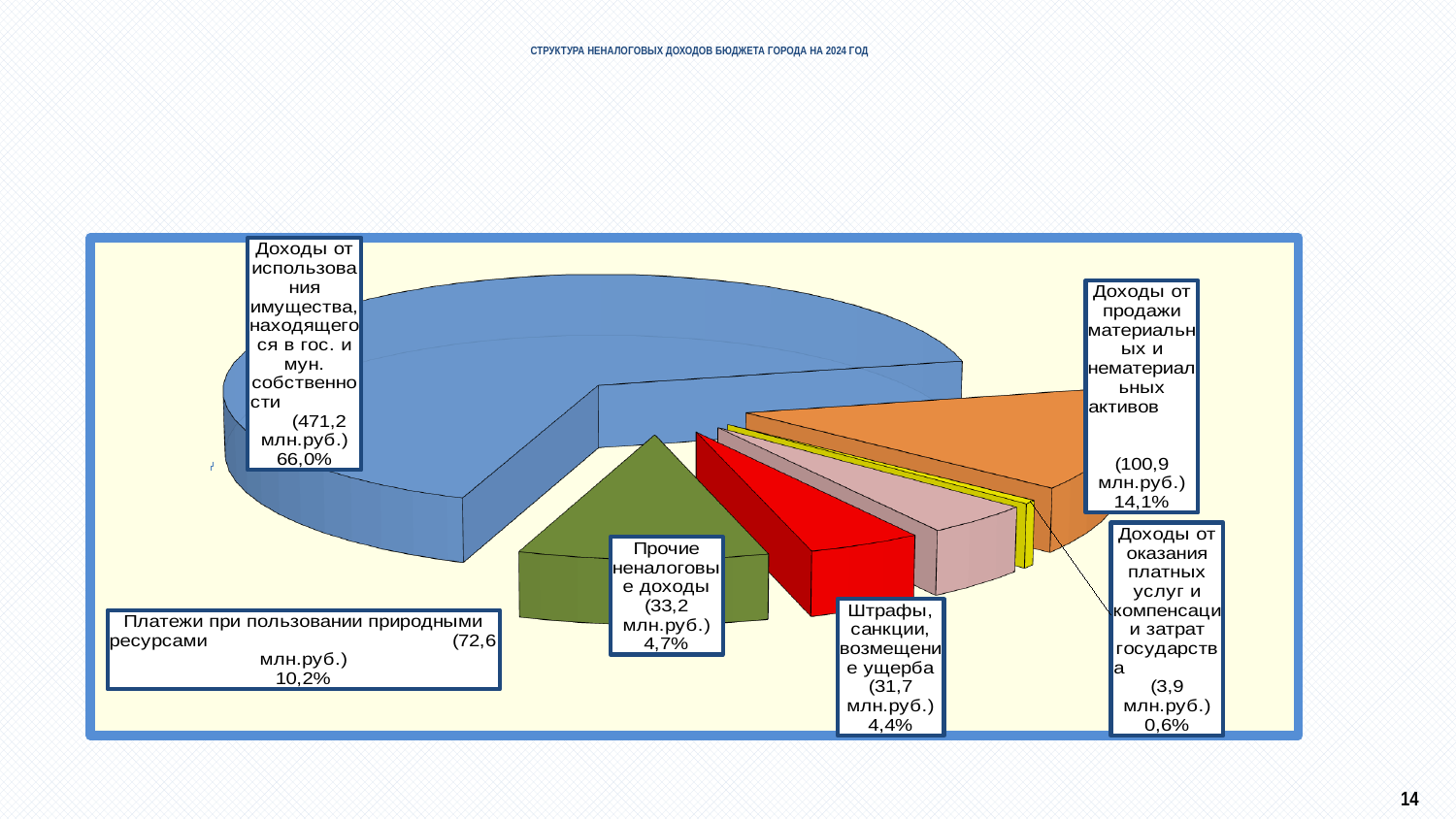
What percentage share is shown for 'Штрафы, санкции, возмещение ущерба'? 4,4% Which category has the smallest share of the pie? Доходы от оказания платных услуг и компенсации затрат государства What colour is the slice for 'Доходы от использования имущества, находящегося в гос. и мун. собственности'? Blue What is the title of the chart on the slide? СТРУКТУРА НЕНАЛОГОВЫХ ДОХОДОВ БЮДЖЕТА ГОРОДА НА 2024 ГОД What is the difference in млн.руб. between 'Прочие неналоговые доходы' and 'Штрафы, санкции, возмещение ущерба'? 1,5 млн.руб. Which category has the largest share of the pie? Доходы от использования имущества, находящегося в гос. и мун. собственности What share of the pie does 'Доходы от продажи материальных и нематериальных активов' represent? 14,1% What is the value for 'Доходы от использования имущества, находящегося в гос. и мун. собственности' in млн.руб.? 471,2 млн.руб. How many slices does the pie chart have? 6 Which is larger: 'Платежи при пользовании природными ресурсами' or 'Прочие неналоговые доходы'? Платежи при пользовании природными ресурсами What is the value for 'Платежи при пользовании природными ресурсами' in млн.руб.? 72,6 млн.руб. What type of chart is shown on the slide? Pie chart